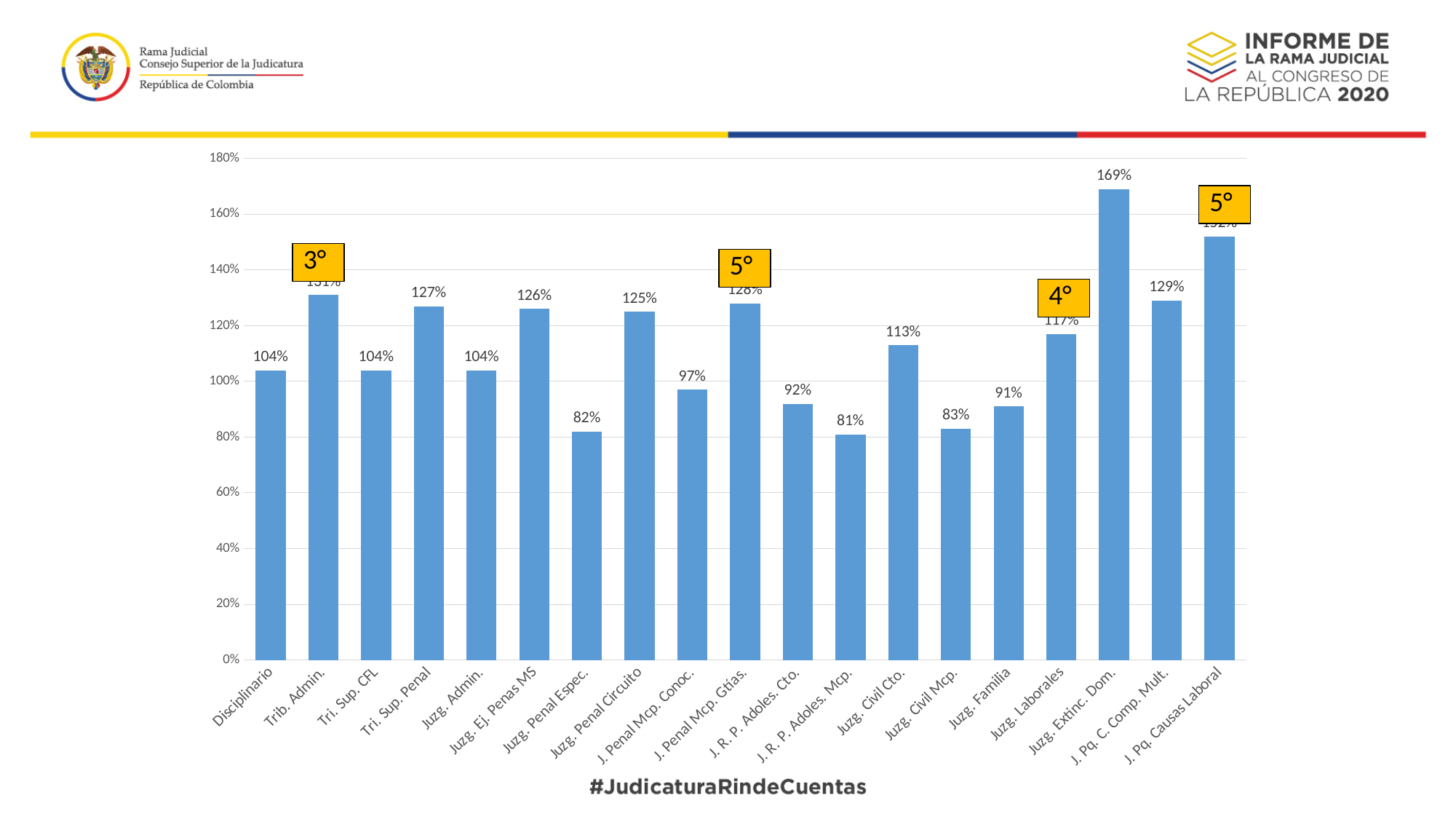
What kind of chart is shown on the slide? bar chart What is the value for Juzg. Extinc. Dom.? 169% Which category has the highest value? Juzg. Extinc. Dom. Which is larger, the value for Juzg. Ej. Penas MS or the value for Juzg. Penal Espec.? Juzg. Ej. Penas MS What is the value for J. Penal Mcp. Conoc.? 97% What is the value for Juzg. Familia? 91% What is the value for Tri. Sup. Penal? 127% What is the value for Juzg. Civil Cto.? 113% How many categories are shown on the x axis? 19 What is the difference between the values for Juzg. Extinc. Dom. and J. Pq. C. Comp. Mult.? 40% What hashtag is printed below the chart? #JudicaturaRindeCuentas Is the value for Juzg. Civil Mcp. greater or less than 100%? less